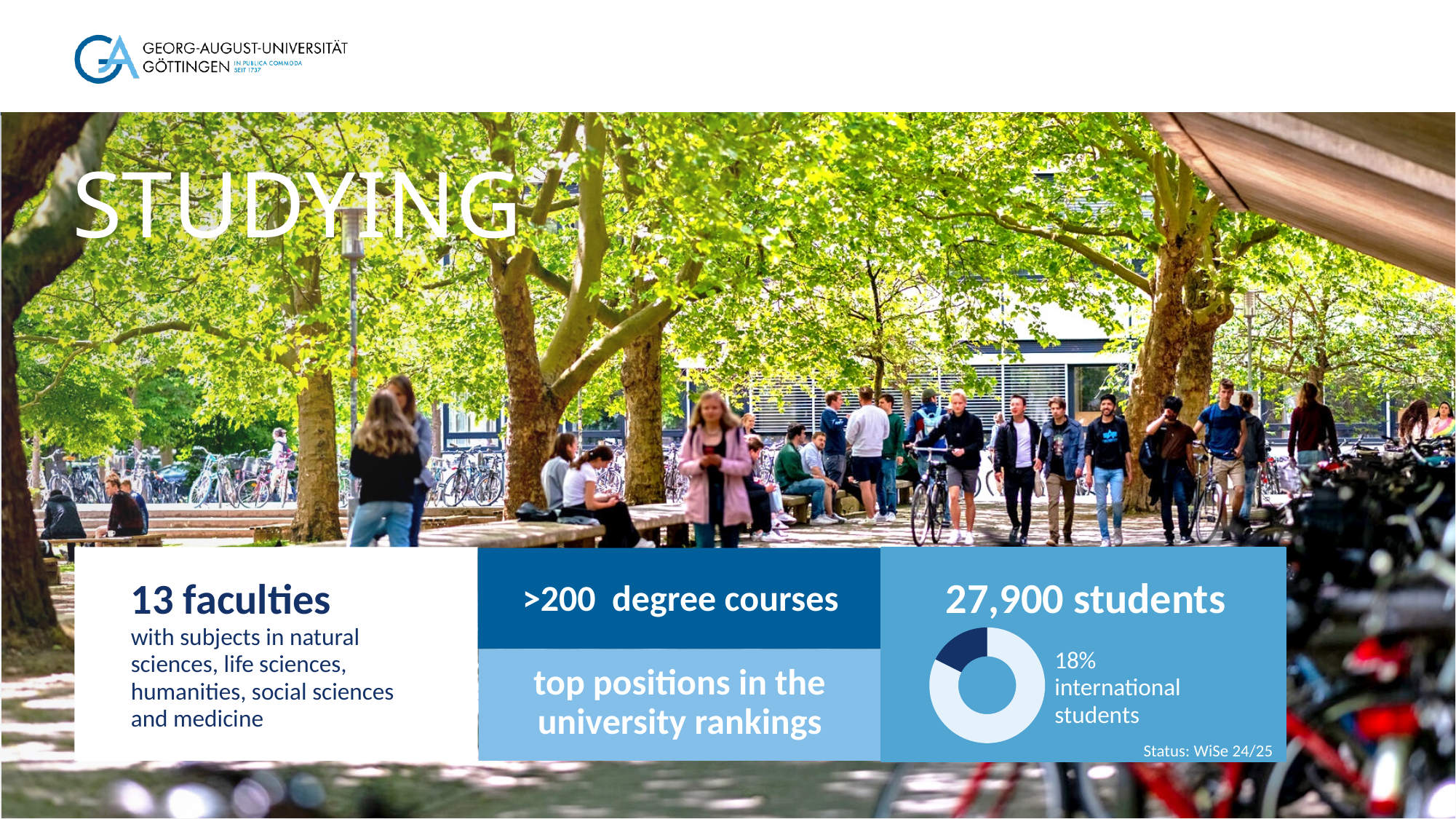
What kind of chart is shown in the '27,900 students' box? doughnut chart How many slices does the doughnut chart have? 2 What status period is given for the doughnut chart data? WiSe 24/25 What colour is the slice representing international students in the doughnut chart? dark blue In the doughnut chart, which slice is larger: the dark blue slice for international students or the light blue slice? the light blue slice In the doughnut chart, what share of students are international students? 18% Is the share of international students in the doughnut chart greater or less than 50%? less